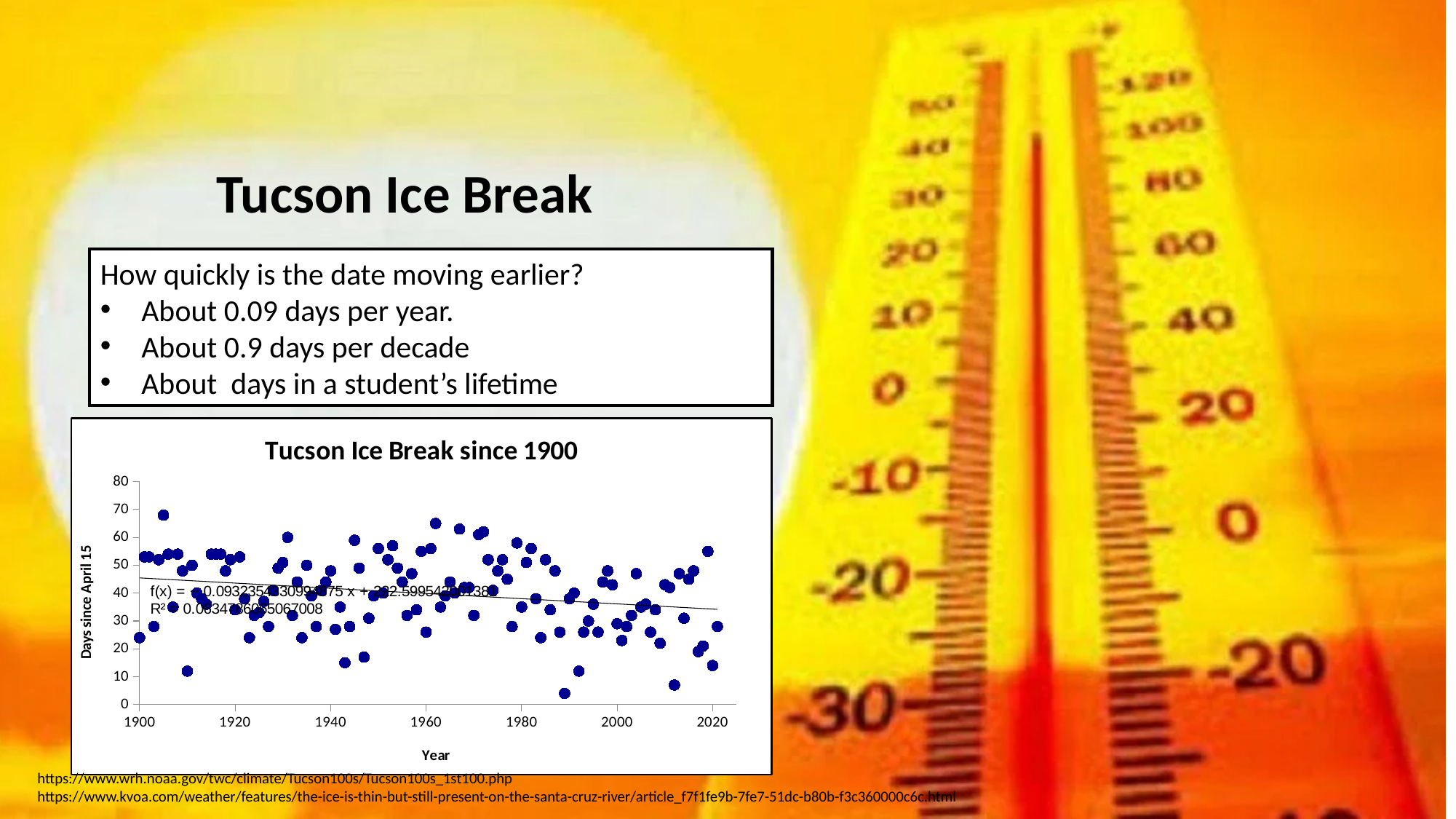
What kind of chart is shown on the slide? Scatter chart What is the title of the vertical axis of the chart? Days since April 15 Is the highest plotted point in the chart greater or less than 60 days since April 15? Greater Is the lowest plotted point in the chart greater or less than 10 days since April 15? Less Does the lowest plotted point occur before or after 1960? After Is the trendline value at the year 1900 greater or less than 40? Greater What is the title of the chart on the slide? Tucson Ice Break since 1900 Does the highest plotted point occur before or after 1960? Before According to the trendline, do the values rise or fall as the year increases? Fall